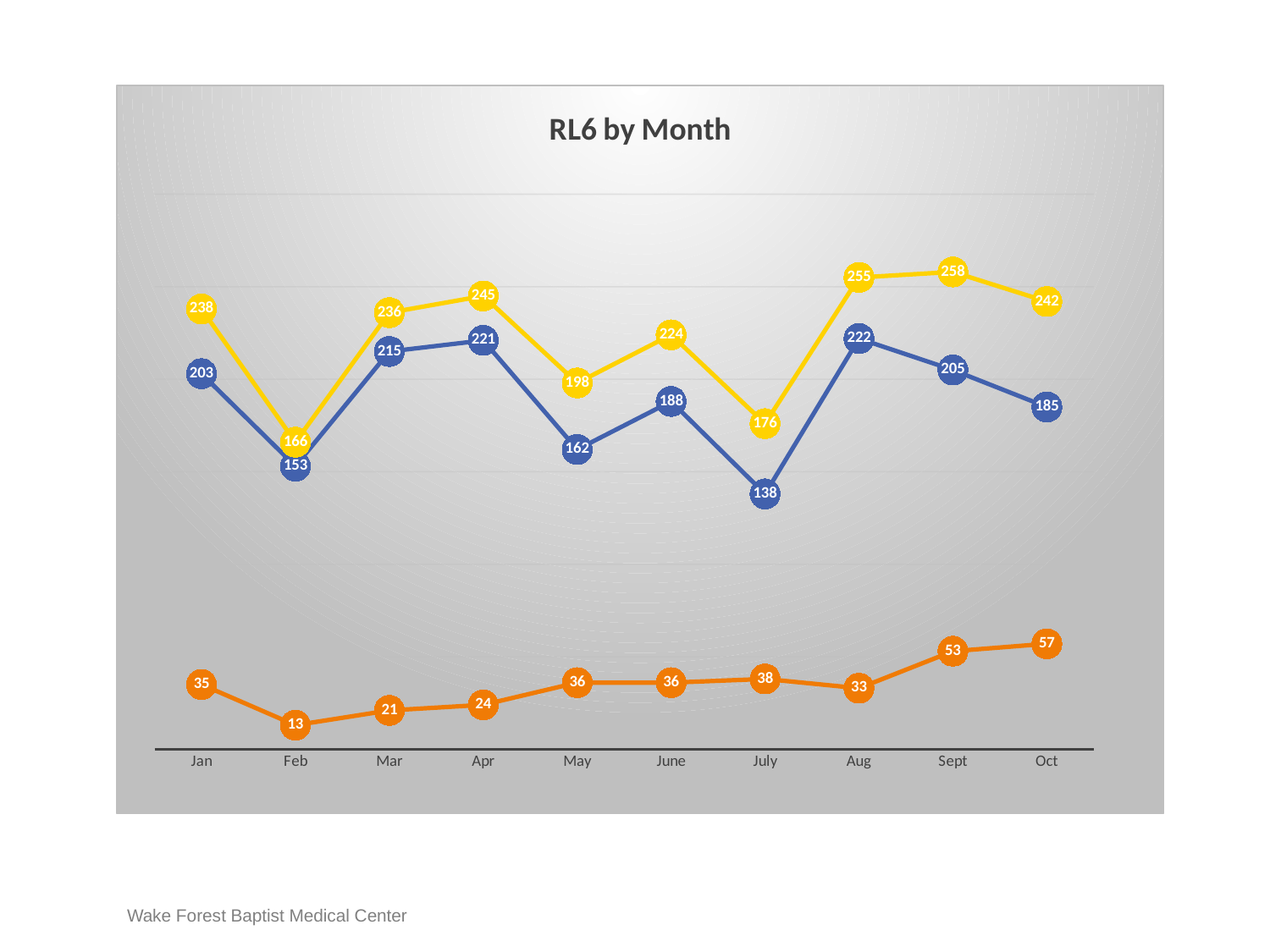
Which is larger, the blue line's value in Apr or its value in Aug? Aug What is the title of the chart? RL6 by Month What is the value of the yellow line in Sept? 258 What is the value of the orange line in Feb? 13 In which month does the blue line reach its lowest value? July In which month does the yellow line reach its highest value? Sept In which month does the orange line reach its highest value? Oct Does the orange line rise or fall from Aug to Oct? rise What is the value of the blue line in July? 138 What is the difference between the yellow line and the blue line in Jan? 35 What kind of chart is shown on the slide? line chart How many months are plotted along the x axis? 10